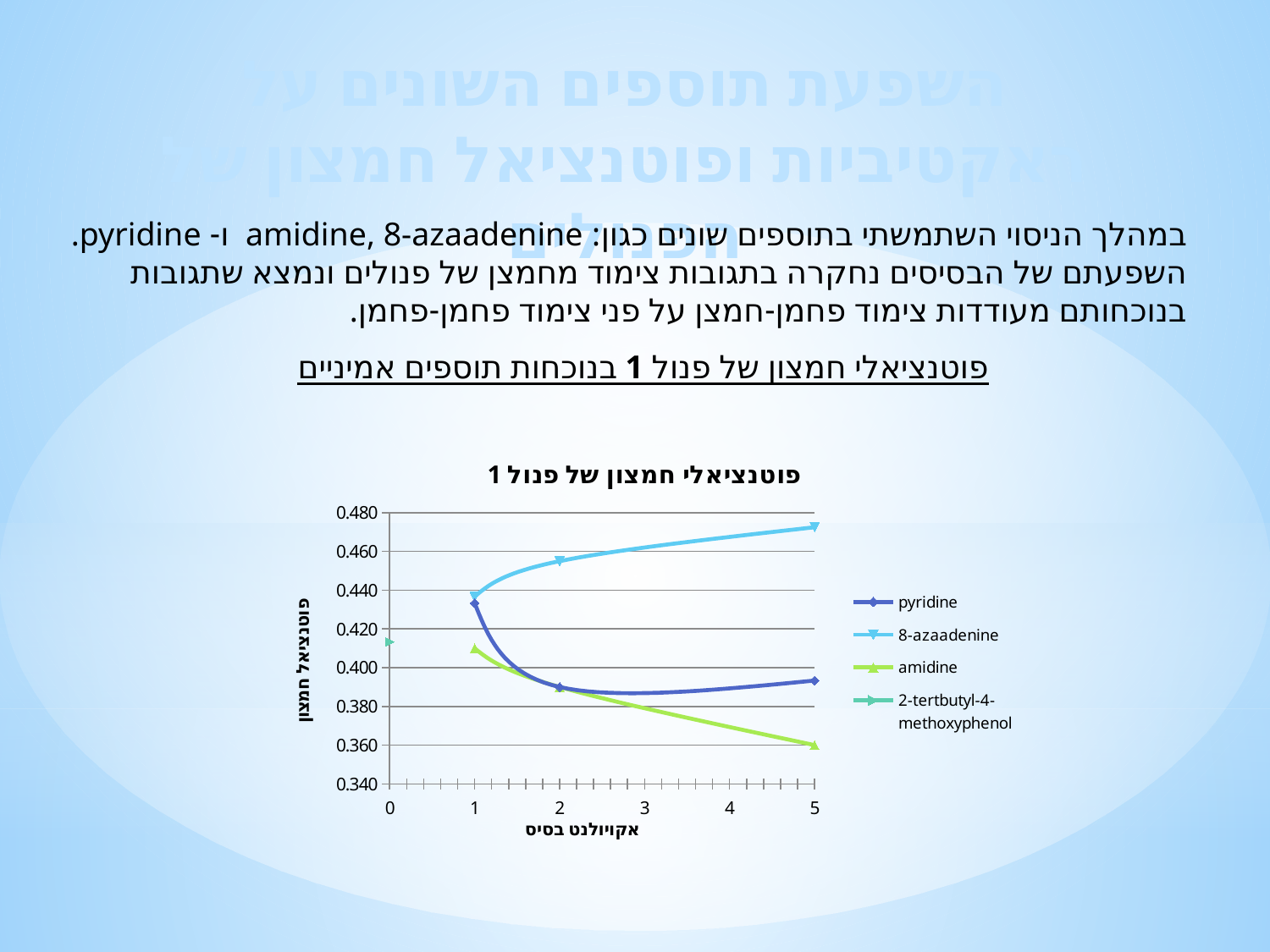
Is the value for amidine at 5 base equivalents greater or less than 0.380? less Is the value for pyridine at 1 base equivalent greater or less than 0.420? greater How many data points are plotted for the 2-tertbutyl-4-methoxyphenol series? 1 Does the amidine line rise or fall as the base equivalents increase from 1 to 5? fall Which series has the lowest value at 5 base equivalents? amidine What is the title of the chart? פוטנציאלי חמצון של פנול 1 Which series has the highest value at 5 base equivalents? 8-azaadenine Is the value for 8-azaadenine at 5 base equivalents greater or less than 0.460? greater How many series does the legend list? 4 At 5 base equivalents, which is larger: the value for 8-azaadenine or the value for amidine? 8-azaadenine Does the 8-azaadenine line rise or fall as the base equivalents increase from 1 to 5? rise What kind of chart is shown on the slide? line chart